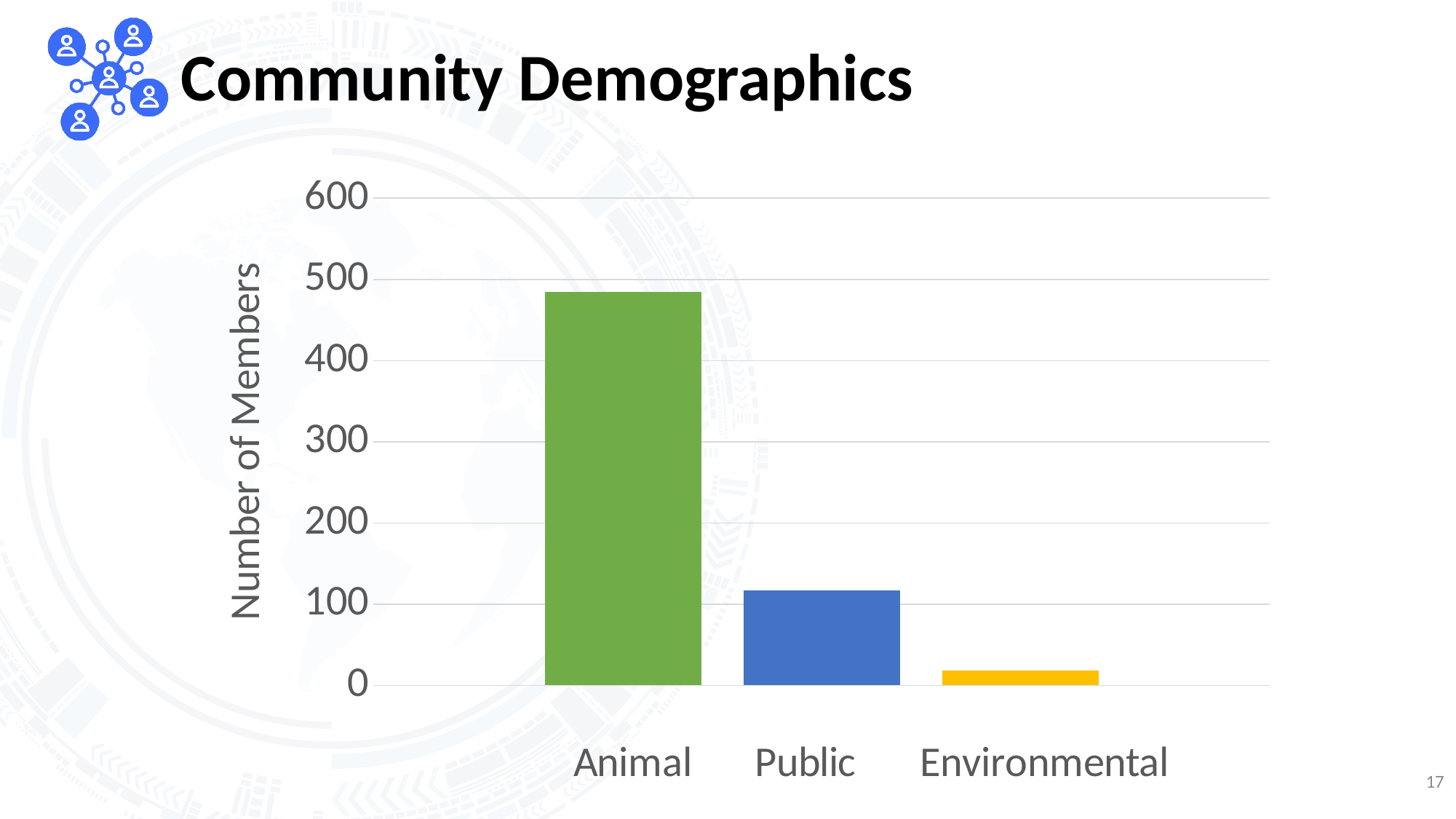
Is the value for Environmental greater or less than 100? less Which category has the lowest number of members? Environmental Which has more members, Public or Environmental? Public Is the value for Animal greater or less than 400? greater Is the value for Animal greater or less than 500? less What is the label of the vertical axis? Number of Members Do the values rise or fall from left to right along the x axis? fall How many categories are shown on the x axis of the chart? 3 What kind of chart is shown on the slide? bar chart Which category has the highest number of members? Animal